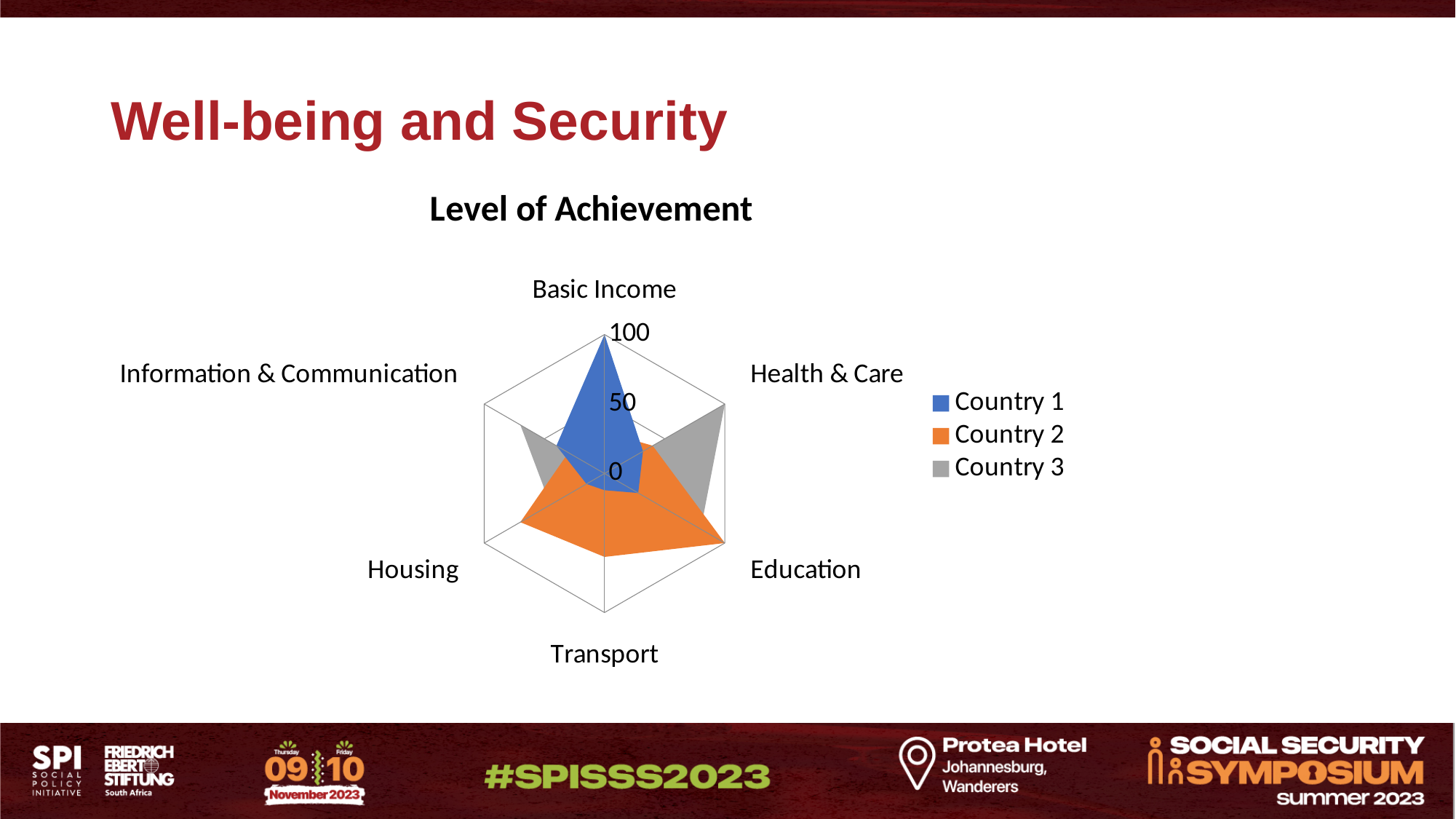
Which category has the highest value for Country 1? Basic Income Which colour represents Country 2 in the legend? Orange Is the value for Country 2 on Basic Income greater or less than 50? less What is the title of the chart? Level of Achievement How many categories (axes) does the radar chart have? 6 How many series does the legend list? 3 For Education, which is larger: Country 1 or Country 2? Country 2 What kind of chart is shown on the slide? Radar chart Is the value for Country 1 on Basic Income greater or less than 50? greater Which category has the highest value for Country 3? Health & Care Which category has the highest value for Country 2? Education